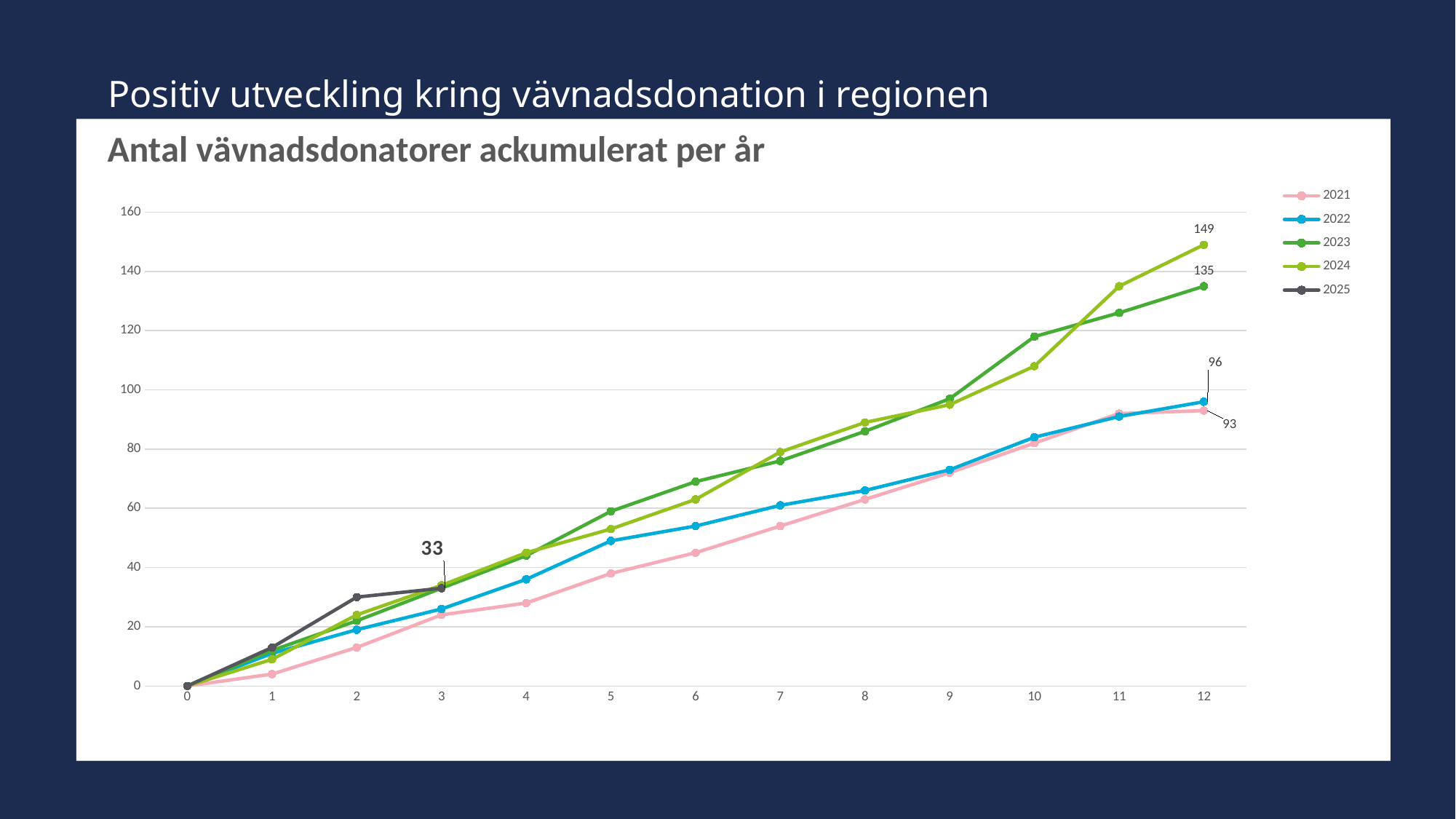
Which is larger at x = 12: the 2022 value or the 2021 value? 2022 How many series does the legend list? 5 Which series has the highest value at x = 12? 2024 What is the value for the 2022 series at x = 12? 96 What type of chart is shown on the slide? Line chart What is the value for the 2025 series at x = 3? 33 What is the difference between the 2024 and 2023 values at x = 12? 14 What is the value for the 2024 series at x = 12? 149 Is the value for the 2023 series at x = 10 greater or less than 100? greater What is the title of the chart? Antal vävnadsdonatorer ackumulerat per år Do the values of the 2024 series rise or fall along the x axis? Rise What is the value for the 2023 series at x = 12? 135